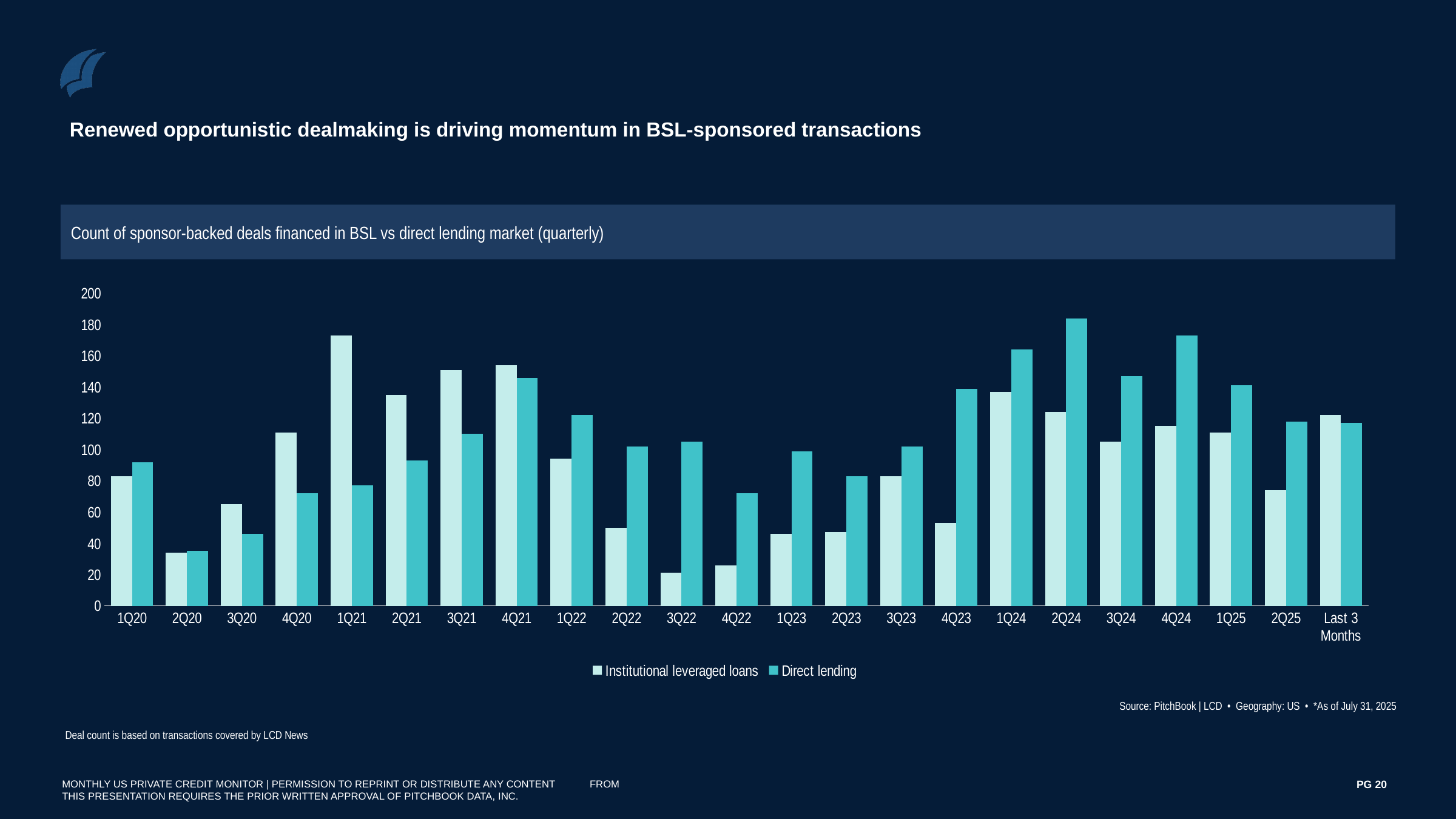
In which quarter is the Institutional leveraged loans bar highest? 1Q21 How many categories are shown along the x axis? 23 In 1Q21, which series has the larger value: Institutional leveraged loans or Direct lending? Institutional leveraged loans In which quarter is the Direct lending bar highest? 2Q24 In which quarter is the Institutional leveraged loans bar lowest? 3Q22 Is the Institutional leveraged loans value for 1Q21 greater or less than 160? greater Is the Direct lending value for 2Q24 greater or less than 180? greater Is the Institutional leveraged loans value for 3Q22 greater or less than 40? less What is the title of the chart? Count of sponsor-backed deals financed in BSL vs direct lending market (quarterly) In 4Q23, which series has the larger value: Institutional leveraged loans or Direct lending? Direct lending What kind of chart is shown on the slide? Bar chart How many series does the legend list? 2